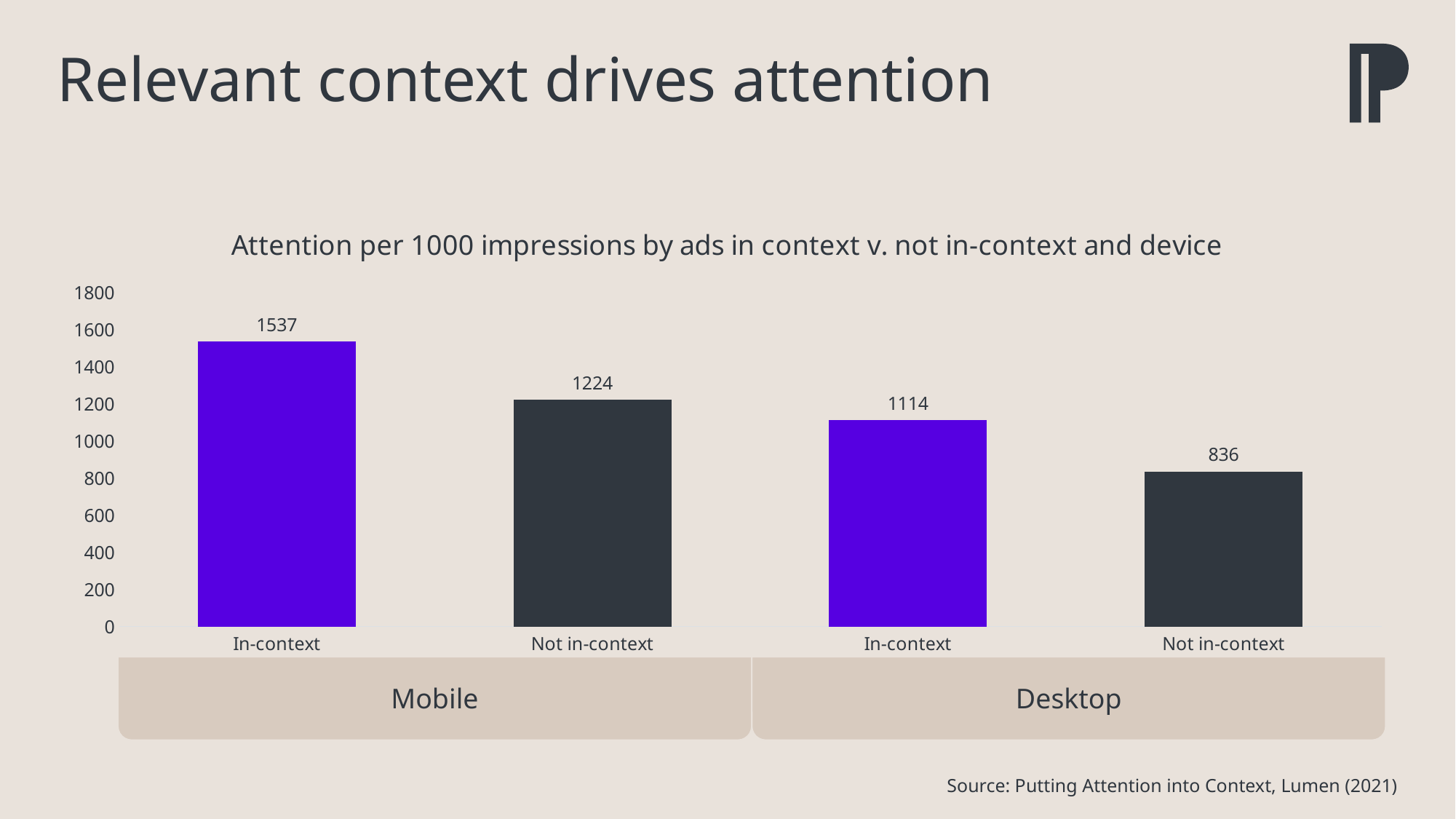
What is the title of the chart? Attention per 1000 impressions by ads in context v. not in-context and device What is the attention per 1000 impressions for In-context ads on Desktop? 1114 Which bar has the lowest value in the chart? Not in-context (Desktop) What is the attention per 1000 impressions for In-context ads on Mobile? 1537 What type of chart is shown on the slide? Bar chart What is the difference between In-context and Not in-context attention on Desktop? 278 How many bars are plotted in the chart? 4 What is the difference between In-context and Not in-context attention on Mobile? 313 Which is larger: Not in-context on Mobile or In-context on Desktop? Not in-context on Mobile What is the attention per 1000 impressions for Not in-context ads on Desktop? 836 Which bar has the highest value in the chart? In-context (Mobile) Is the value for Not in-context on Desktop greater or less than 1000? less